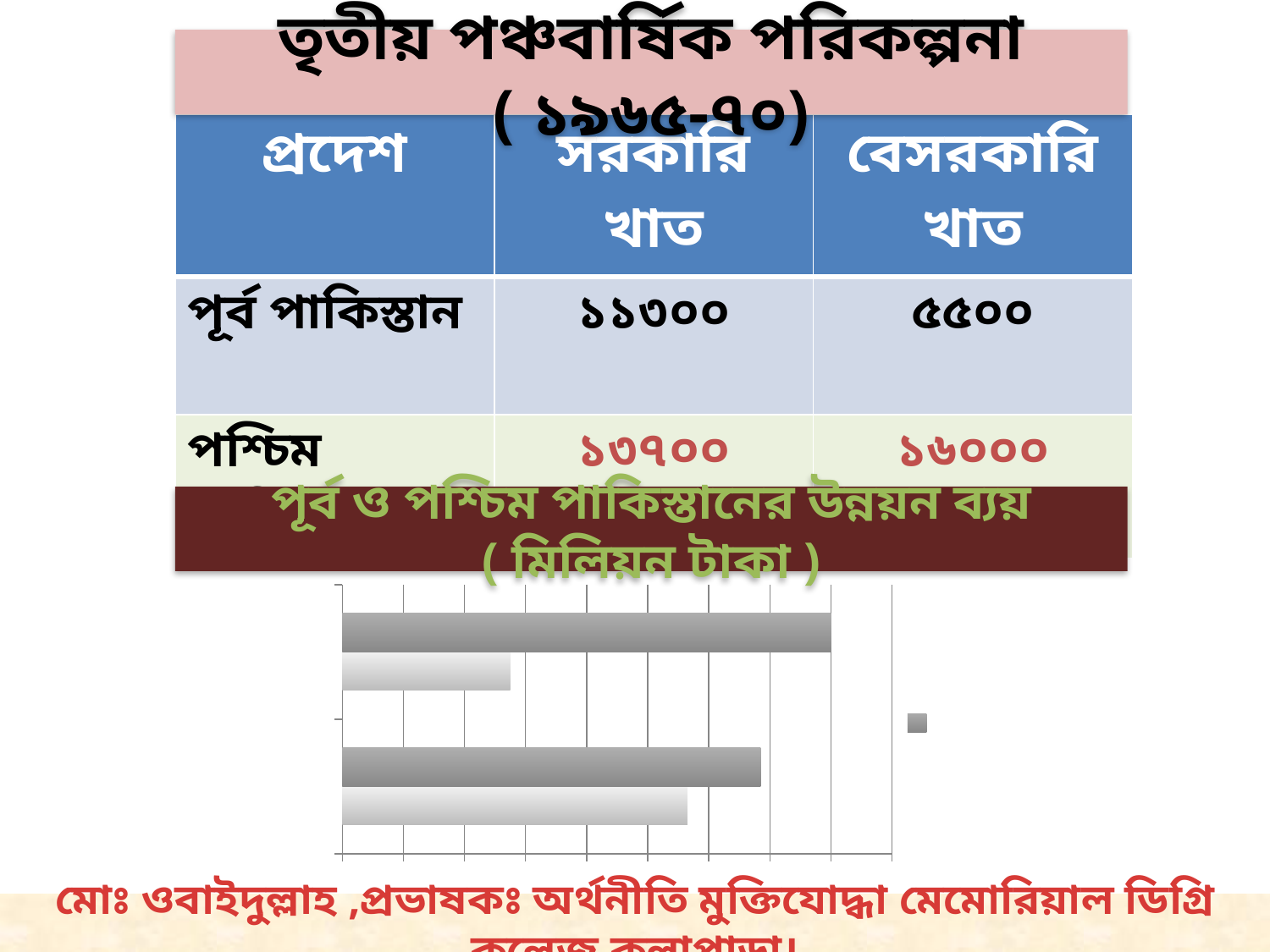
Which bar in the chart is the shortest: the second bar from the top or the bottommost bar? the second bar from the top Which bar in the chart is the longest: the topmost bar or the bottommost bar? the topmost bar Is the topmost bar in the chart longer or shorter than the bar directly below it? longer Are the bars in the chart drawn horizontally or vertically? horizontally Into how many groups are the bars in the chart arranged? 2 How many bars are plotted in the chart? 4 What kind of chart is shown at the bottom of the slide? bar chart